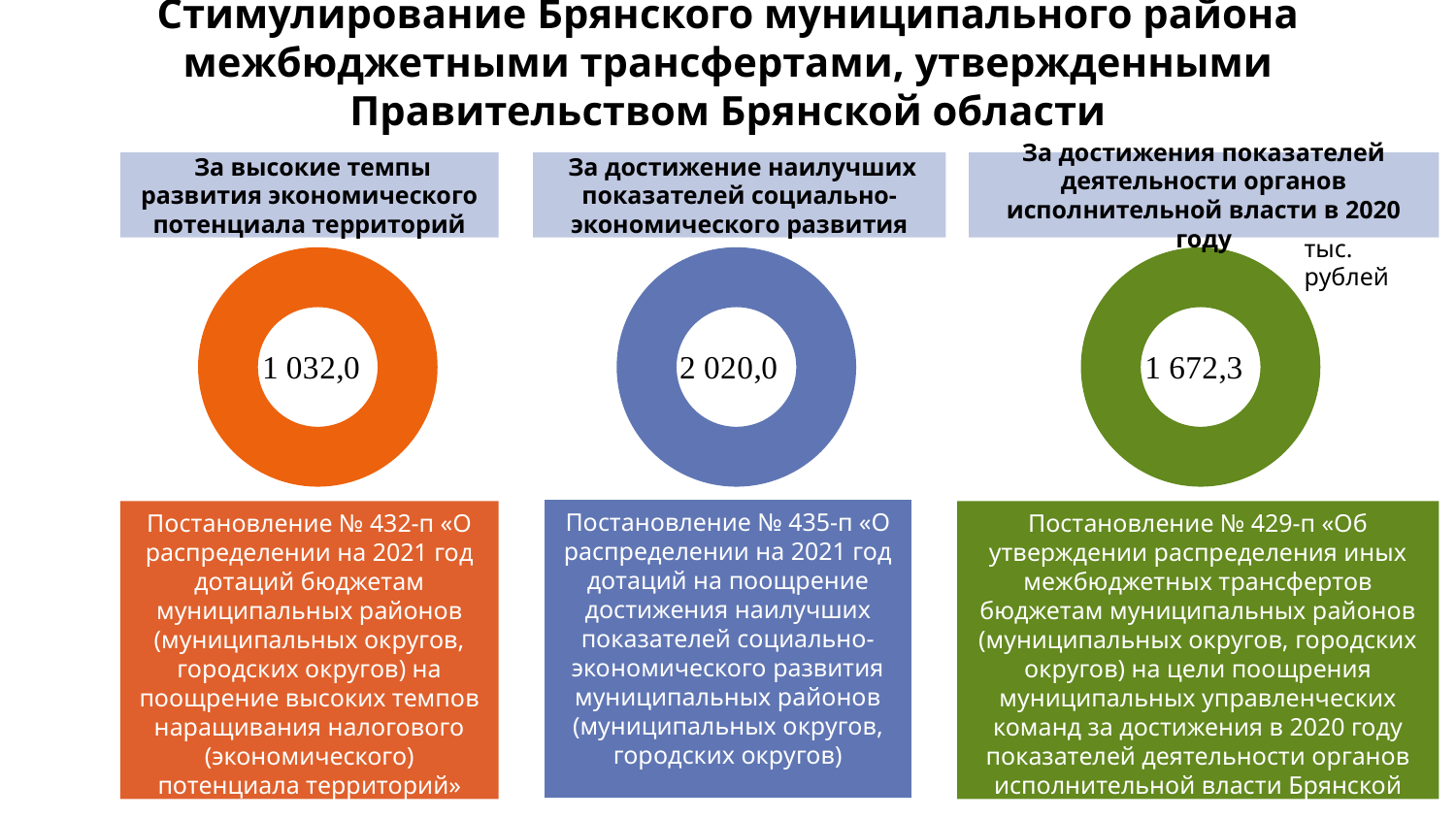
What is the difference between the value in the right donut chart (1 672,3) and the value in the left donut chart (1 032,0)? 640,3 Which of the three donut charts shows the lowest value? За высокие темпы развития экономического потенциала территорий (1 032,0) What value is shown in the centre of the left donut chart (За высокие темпы развития экономического потенциала территорий)? 1 032,0 What is the difference between the value in the middle donut chart (2 020,0) and the value in the right donut chart (1 672,3)? 347,7 What colour is the donut chart for За достижения показателей деятельности органов исполнительной власти в 2020 году? Green What value is shown in the centre of the middle donut chart (За достижение наилучших показателей социально-экономического развития)? 2 020,0 Which is larger: the value in the middle donut chart or the value in the right donut chart? The middle chart (2 020,0) What value is shown in the centre of the right donut chart (За достижения показателей деятельности органов исполнительной власти в 2020 году)? 1 672,3 How many donut charts are shown on the slide? 3 Which of the three donut charts shows the highest value? За достижение наилучших показателей социально-экономического развития (2 020,0) What is the difference between the value in the middle donut chart (2 020,0) and the value in the left donut chart (1 032,0)? 988,0 What type of chart is used on this slide to display the transfer amounts? Donut (pie) chart